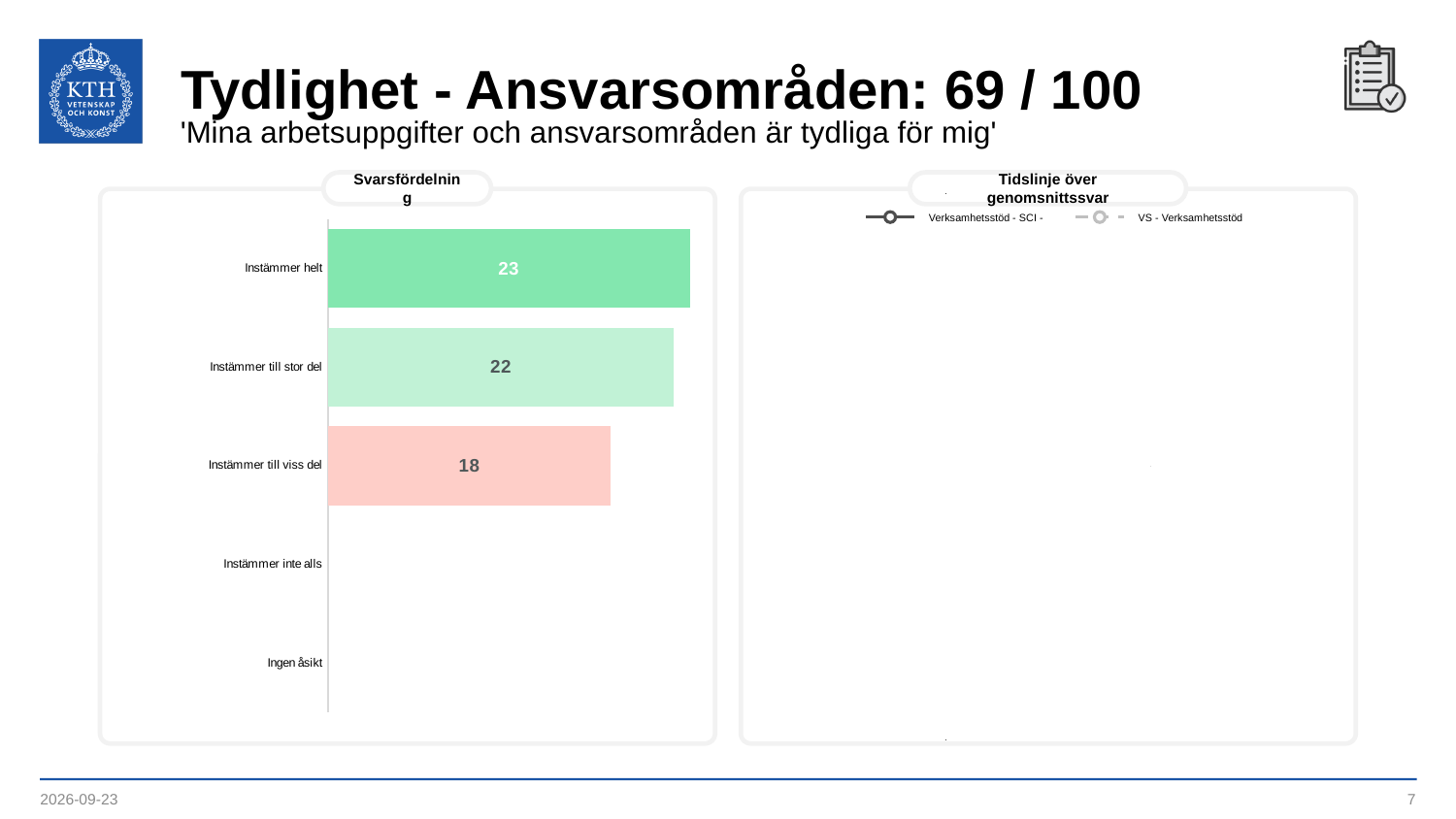
In the 'Svarsfördelning' chart, what is the value for 'Instämmer till viss del'? 18 How many categories are listed on the axis of the 'Svarsfördelning' chart? 5 In the 'Svarsfördelning' chart, which category has the highest value? Instämmer helt In the 'Svarsfördelning' chart, what is the value for 'Instämmer helt'? 23 What is the title of the chart on the left side of the slide? Svarsfördelning In the 'Svarsfördelning' chart, what is the difference between the values for 'Instämmer till stor del' and 'Instämmer till viss del'? 4 In the 'Svarsfördelning' chart, what is the difference between the values for 'Instämmer helt' and 'Instämmer till viss del'? 5 In the 'Svarsfördelning' chart, which is larger: the value for 'Instämmer till stor del' or 'Instämmer till viss del'? Instämmer till stor del In the 'Svarsfördelning' chart, what is the value for 'Instämmer till stor del'? 22 What kind of chart is the 'Svarsfördelning' chart? Bar chart How many series does the legend of the 'Tidslinje över genomsnittssvar' chart list? 2 In the 'Svarsfördelning' chart, what colour is the bar for 'Instämmer till viss del'? Light red/pink